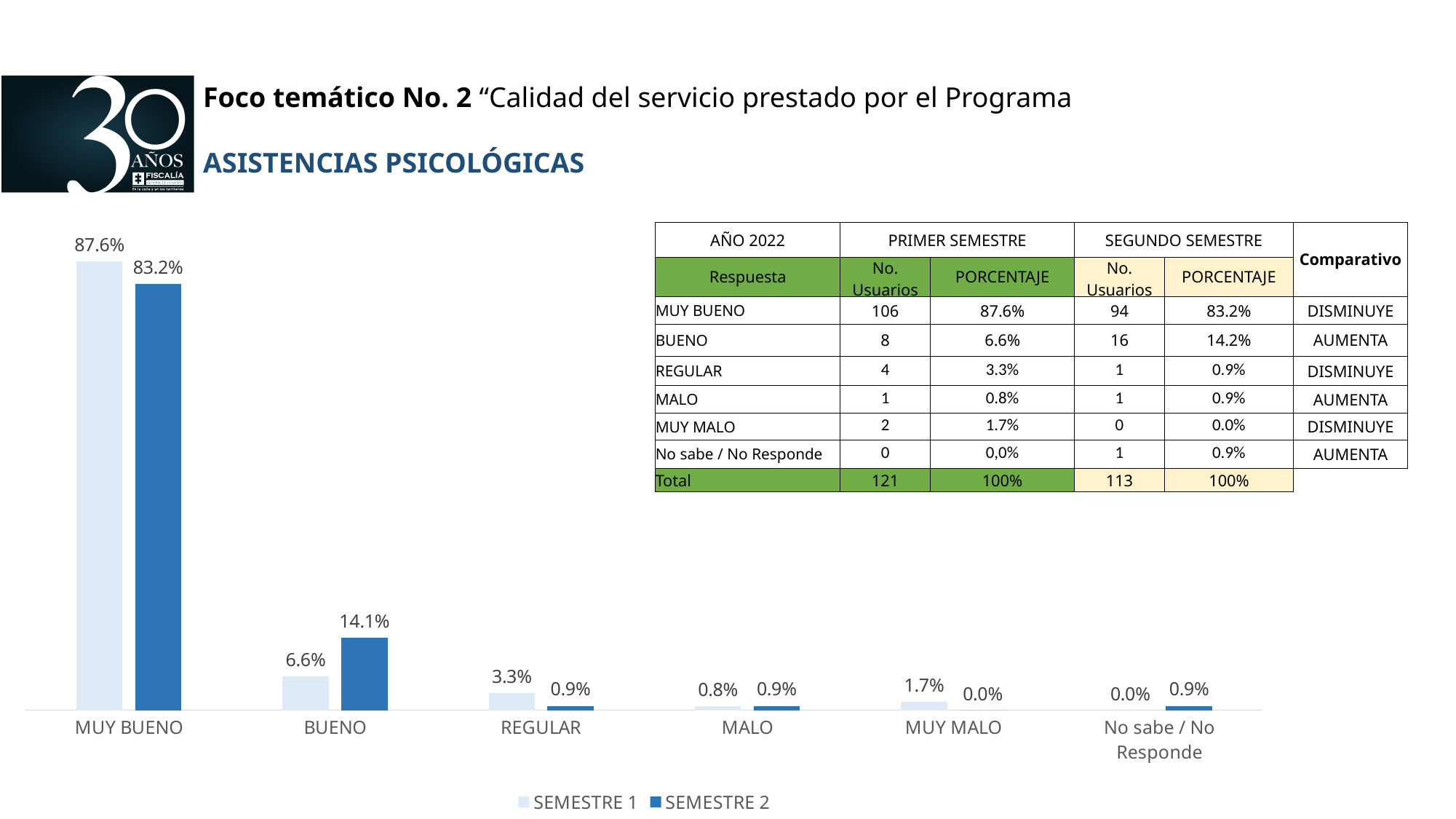
How many categories are shown on the x axis of the chart? 6 What is the value for BUENO in the SEMESTRE 1 series? 6.6% How many series does the chart legend list? 2 What is the value for MUY MALO in the SEMESTRE 2 series? 0.0% What is the value for MUY BUENO in the SEMESTRE 2 series? 83.2% What is the difference between the SEMESTRE 1 and SEMESTRE 2 values for MUY BUENO? 4.4% Which category has the highest value in the SEMESTRE 2 series? MUY BUENO Which category has the lowest value in the SEMESTRE 1 series? No sabe / No Responde What is the value for REGULAR in the SEMESTRE 1 series? 3.3% What is the value for MUY BUENO in the SEMESTRE 1 series? 87.6% Which is larger for REGULAR, the SEMESTRE 1 value or the SEMESTRE 2 value? SEMESTRE 1 What kind of chart is shown on the slide? Bar chart